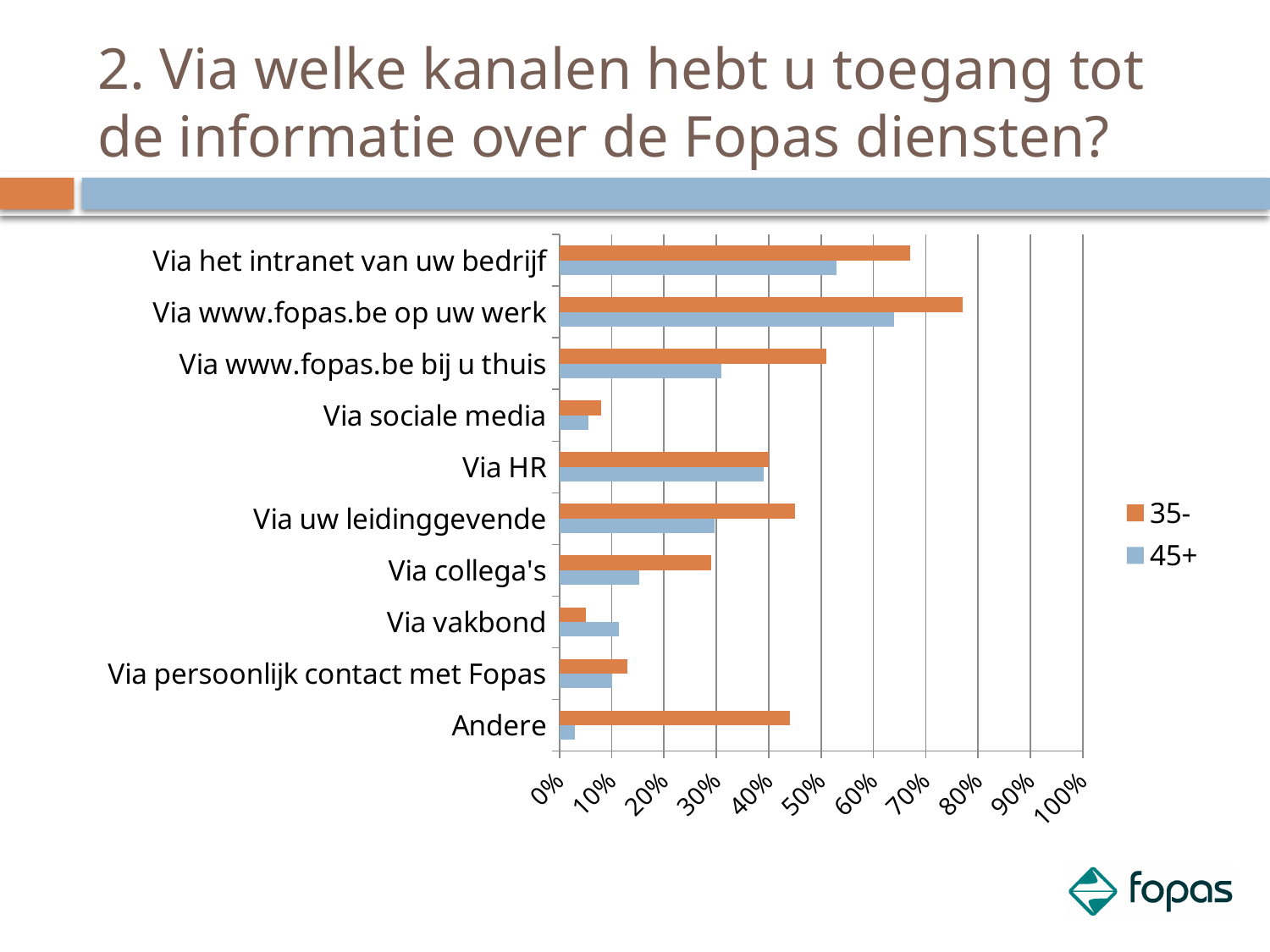
Which channel has the lowest value for the 45+ series? Andere Which channel has the highest value for the 45+ series? Via www.fopas.be op uw werk How many series does the legend list? 2 Which colour represents the 45+ series in the legend? Blue For 'Andere', which series has the larger value, 35- or 45+? 35- What kind of chart is shown on the slide? Bar chart Is the value for 'Via www.fopas.be bij u thuis' in the 45+ series greater or less than 40%? less For 'Via vakbond', which series has the larger value, 35- or 45+? 45+ How many categories (channels) are shown on the chart? 10 Is the value for 'Via sociale media' in the 35- series greater or less than 20%? less Which channel has the highest value for the 35- series? Via www.fopas.be op uw werk Is the value for 'Via www.fopas.be op uw werk' in the 35- series greater or less than 70%? greater